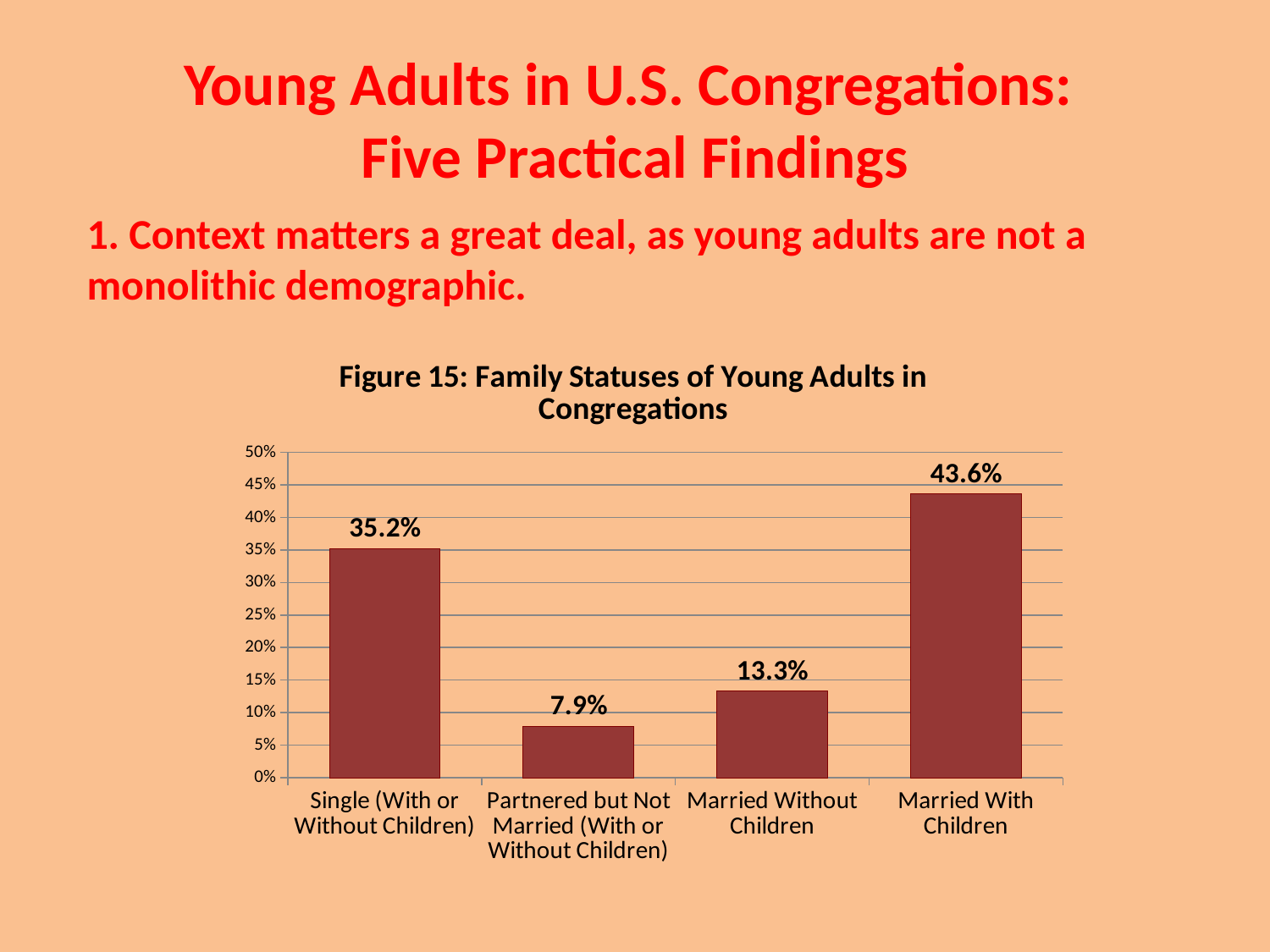
Which category has the highest value? Married With Children What is the value for Married With Children? 43.6% Is the value for Married With Children greater or less than 40%? greater Which category has the lowest value? Partnered but Not Married (With or Without Children) What is the value for Married Without Children? 13.3% Which is larger, the value for Married Without Children or the value for Partnered but Not Married (With or Without Children)? Married Without Children What kind of chart is shown on the slide? bar chart What is the value for Partnered but Not Married (With or Without Children)? 7.9% How many categories are shown in the chart? 4 What is the title of the chart? Figure 15: Family Statuses of Young Adults in Congregations What is the value for Single (With or Without Children)? 35.2% What is the difference between the values for Married With Children and Single (With or Without Children)? 8.4%